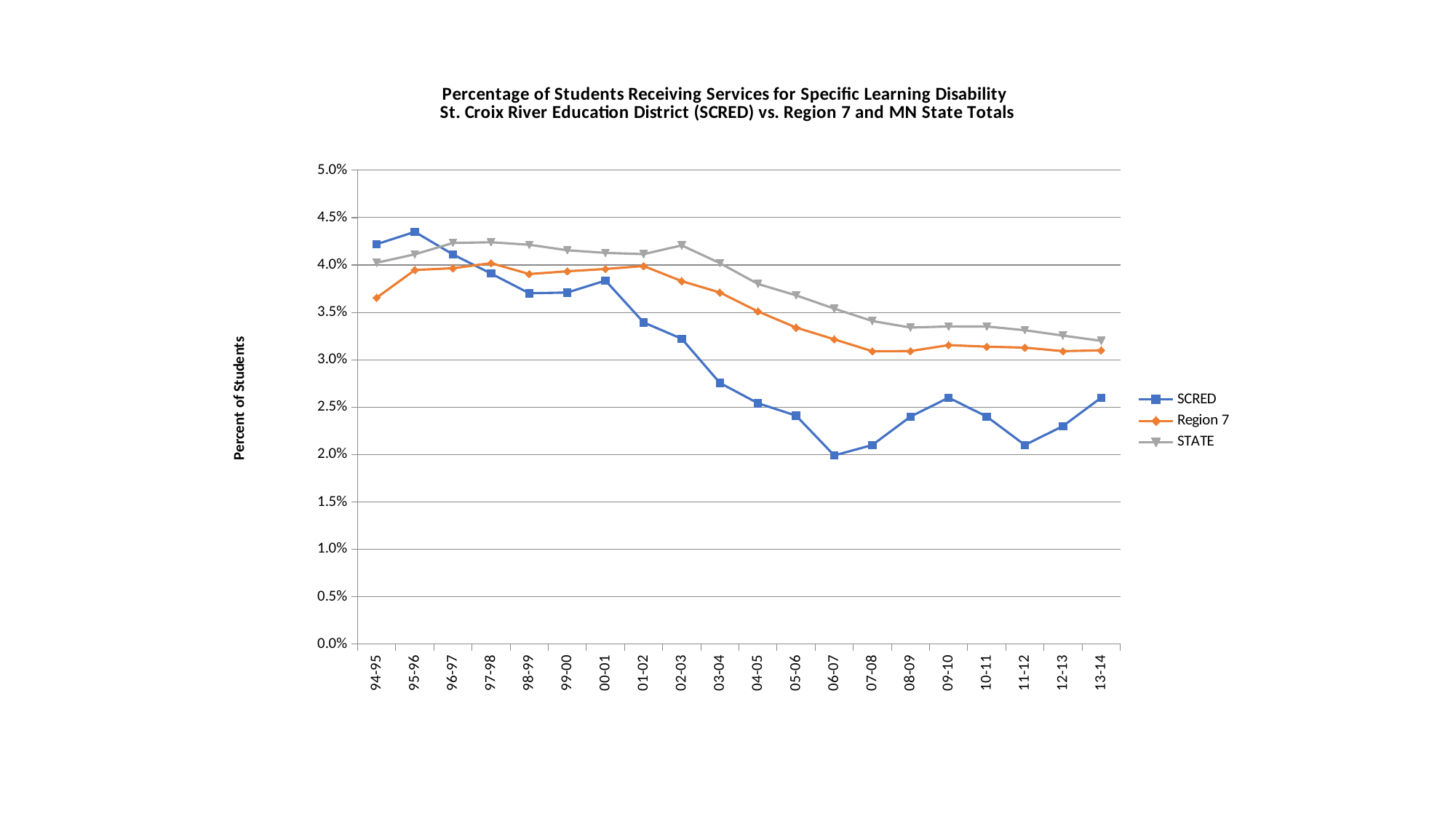
Which series has the highest value in 13-14? STATE Does the STATE series generally rise or fall from 94-95 to 13-14? fall In which school year does the SCRED series reach its highest value? 95-96 Is the value for Region 7 in 94-95 greater or less than 3.5%? greater What is the title of the vertical axis? Percent of Students How many school years are plotted along the x axis? 20 Is the value for SCRED in 13-14 greater or less than 2.5%? greater Which series has the lowest value in 06-07? SCRED How many series does the legend list? 3 In 94-95, which is larger: the SCRED value or the Region 7 value? SCRED Is the value for SCRED in 05-06 greater or less than 2.5%? less What kind of chart is shown on the slide? line chart